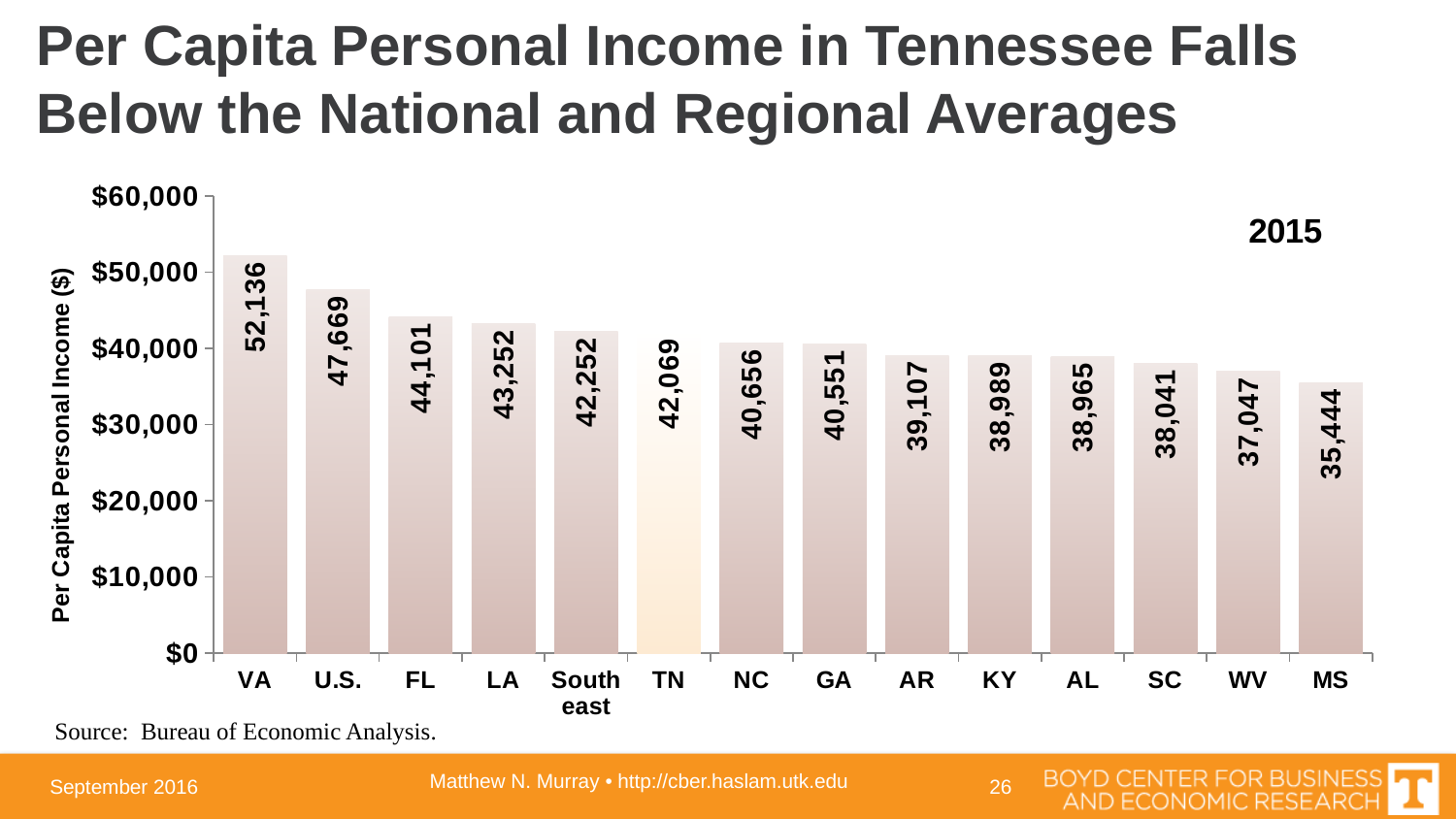
Which is larger, the value for FL or the value for LA? FL What year is labeled on the chart? 2015 What is the per capita personal income for the U.S.? 47,669 What kind of chart is shown on the slide? bar chart What is the per capita personal income for the Southeast? 42,252 What is the difference between the VA value and the MS value? 16,692 Which category has the lowest per capita personal income? MS Which category has the highest per capita personal income? VA How many categories are shown on the x axis? 14 What is the difference between the U.S. value and the TN value? 5,600 What is the per capita personal income for TN? 42,069 Is the value for VA greater or less than $50,000? greater